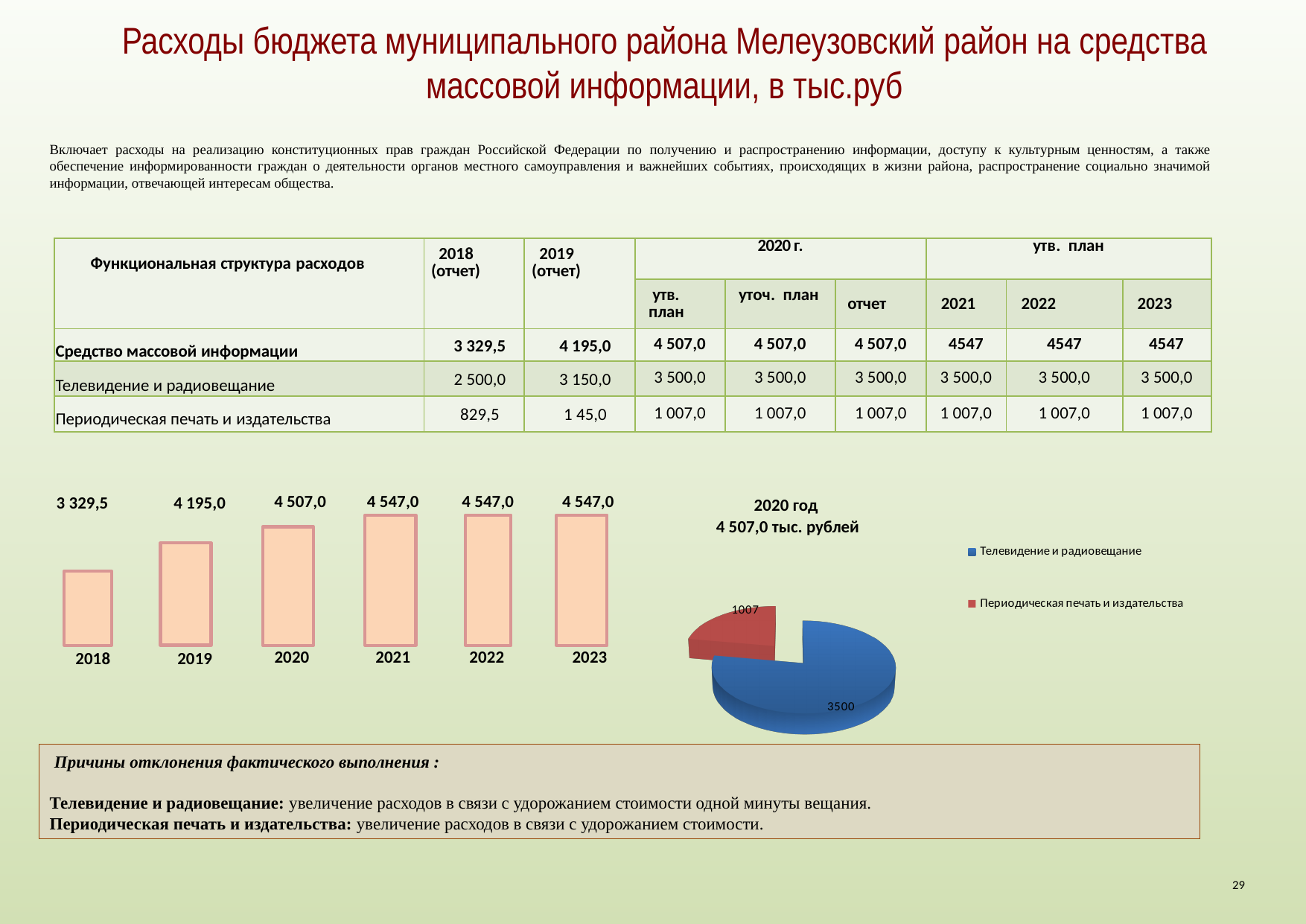
In the bar chart on the left, what is the difference between the values for 2021 and 2020? 40,0 In the bar chart on the left, what is the value for 2018? 3 329,5 How many bars are shown in the bar chart on the left? 6 How many entries does the legend of the pie chart titled '2020 год' list? 2 In the bar chart on the left, what is the difference between the values for 2019 and 2018? 865,5 In the bar chart on the left, which is larger, the value for 2019 or the value for 2020? 2020 What kind of chart is the chart on the right titled '2020 год'? pie chart In the bar chart on the left, which year has the lowest value? 2018 In the bar chart on the left, do the values rise or fall from 2018 to 2020? rise In the bar chart on the left, what is the value for 2020? 4 507,0 In the pie chart titled '2020 год', what is the value for Телевидение и радиовещание? 3500 In the pie chart titled '2020 год', what is the value for Периодическая печать и издательства? 1007